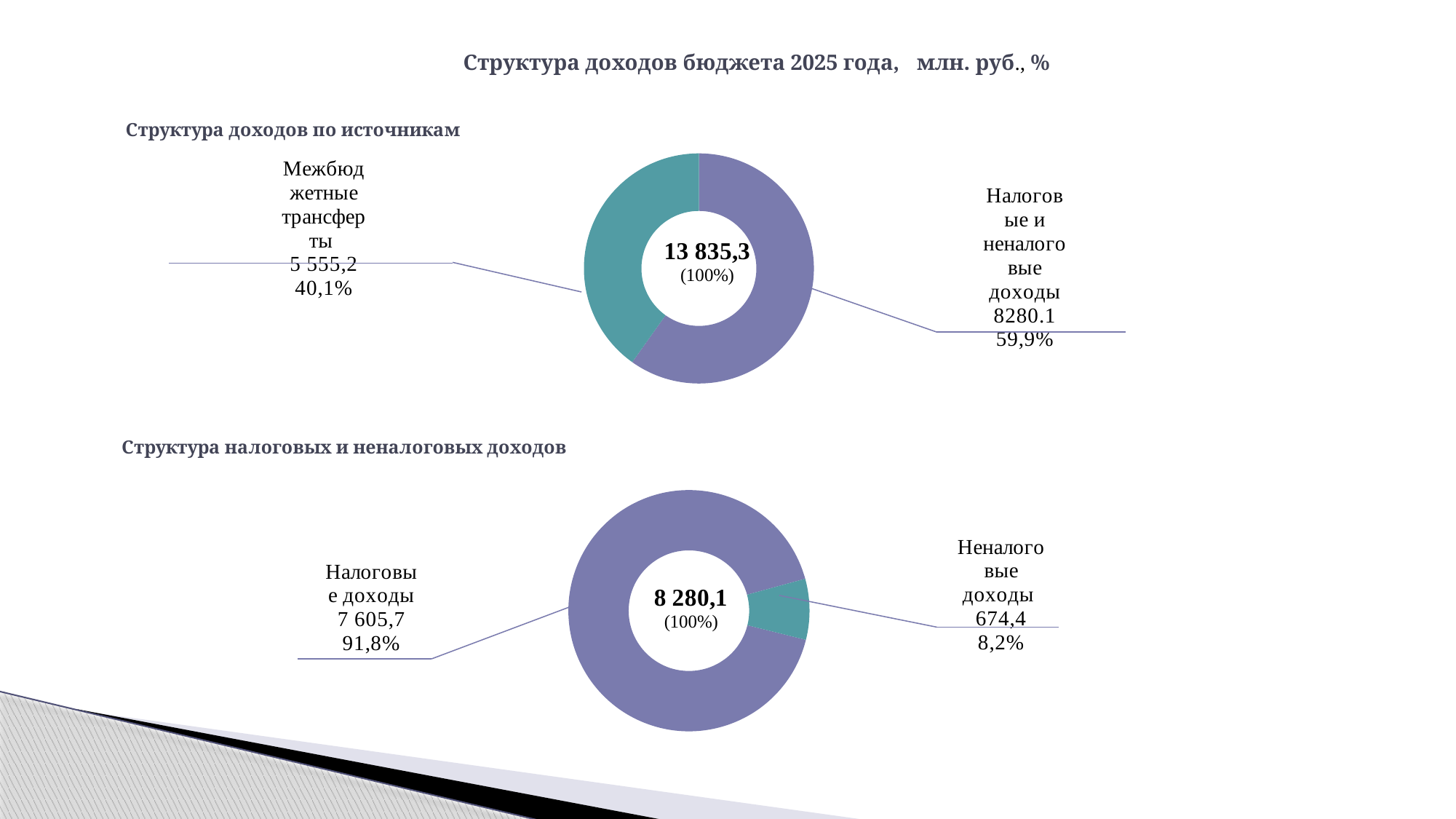
In the top chart 'Структура доходов по источникам', what total is shown in the centre of the doughnut? 13 835,3 In the top chart 'Структура доходов по источникам', which category is the largest? Налоговые и неналоговые доходы In the top chart 'Структура доходов по источникам', what is the value for 'Межбюджетные трансферты'? 5 555,2 In the top chart 'Структура доходов по источникам', how many categories are shown? 2 In the top chart 'Структура доходов по источникам', what share of the total do 'Налоговые и неналоговые доходы' make up? 59,9% What kind of chart is used in the top chart 'Структура доходов по источникам'? Doughnut chart In the bottom chart 'Структура налоговых и неналоговых доходов', which category is the smallest? Неналоговые доходы In the bottom chart 'Структура налоговых и неналоговых доходов', what is the value for 'Неналоговые доходы'? 674,4 In the bottom chart 'Структура налоговых и неналоговых доходов', what total is shown in the centre of the doughnut? 8 280,1 In the bottom chart 'Структура налоговых и неналоговых доходов', what share of the total do 'Налоговые доходы' make up? 91,8% What is the title of the slide above the two charts? Структура доходов бюджета 2025 года, млн. руб., % In the bottom chart 'Структура налоговых и неналоговых доходов', what is the difference between 'Налоговые доходы' and 'Неналоговые доходы'? 6 931,3